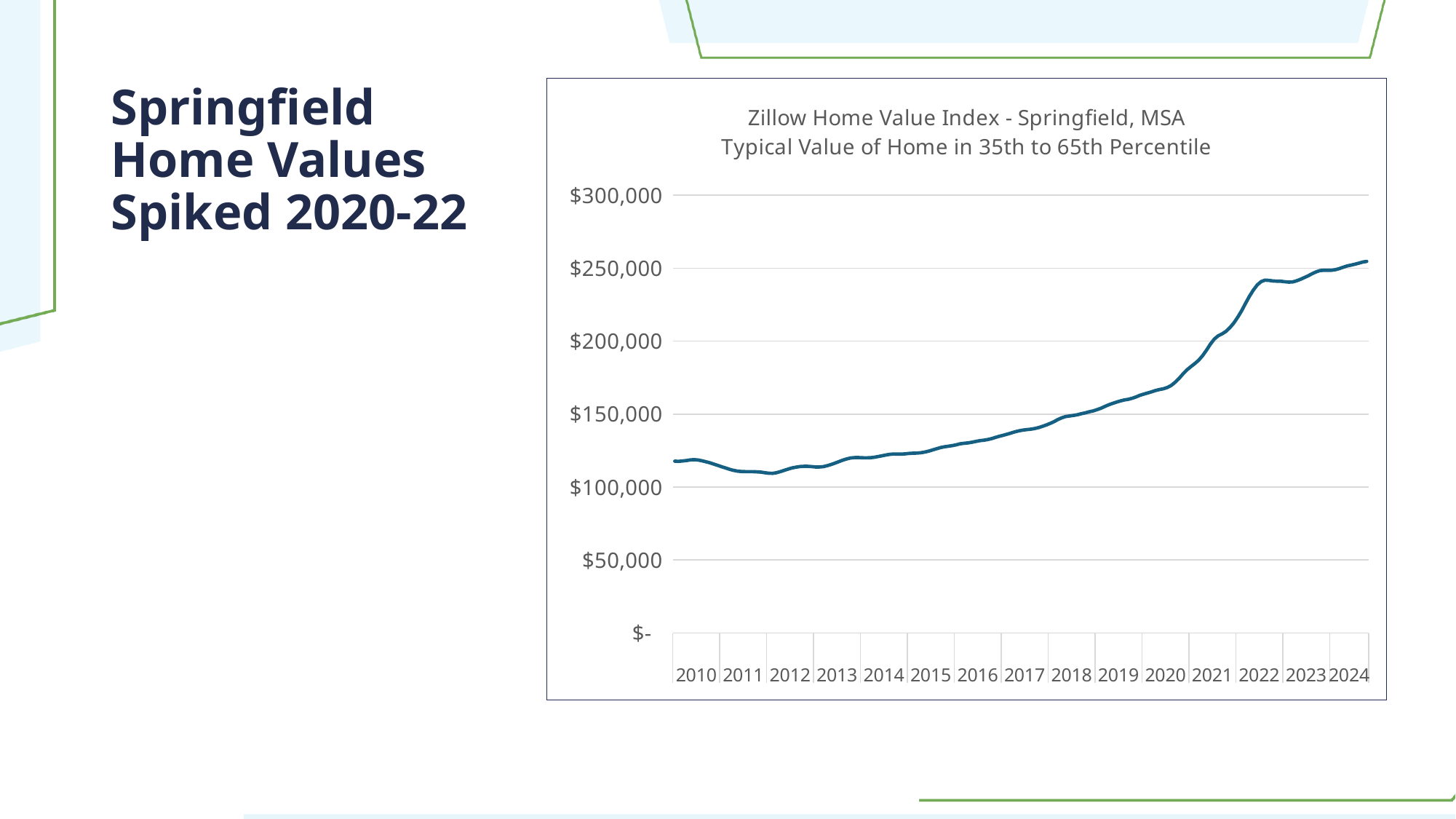
Is the home value at 2024 greater or less than $200,000? greater Is the home value at 2010 greater or less than $100,000? greater What kind of chart is shown on the slide? line chart Which year has the larger home value, 2018 or 2022? 2022 How many year labels are shown on the x axis of the chart? 15 What is the title of the chart? Zillow Home Value Index - Springfield, MSA Typical Value of Home in 35th to 65th Percentile Do home values generally rise or fall from 2013 to 2024? rise Is the home value at 2010 greater or less than $150,000? less Which year on the x axis has the highest home value? 2024